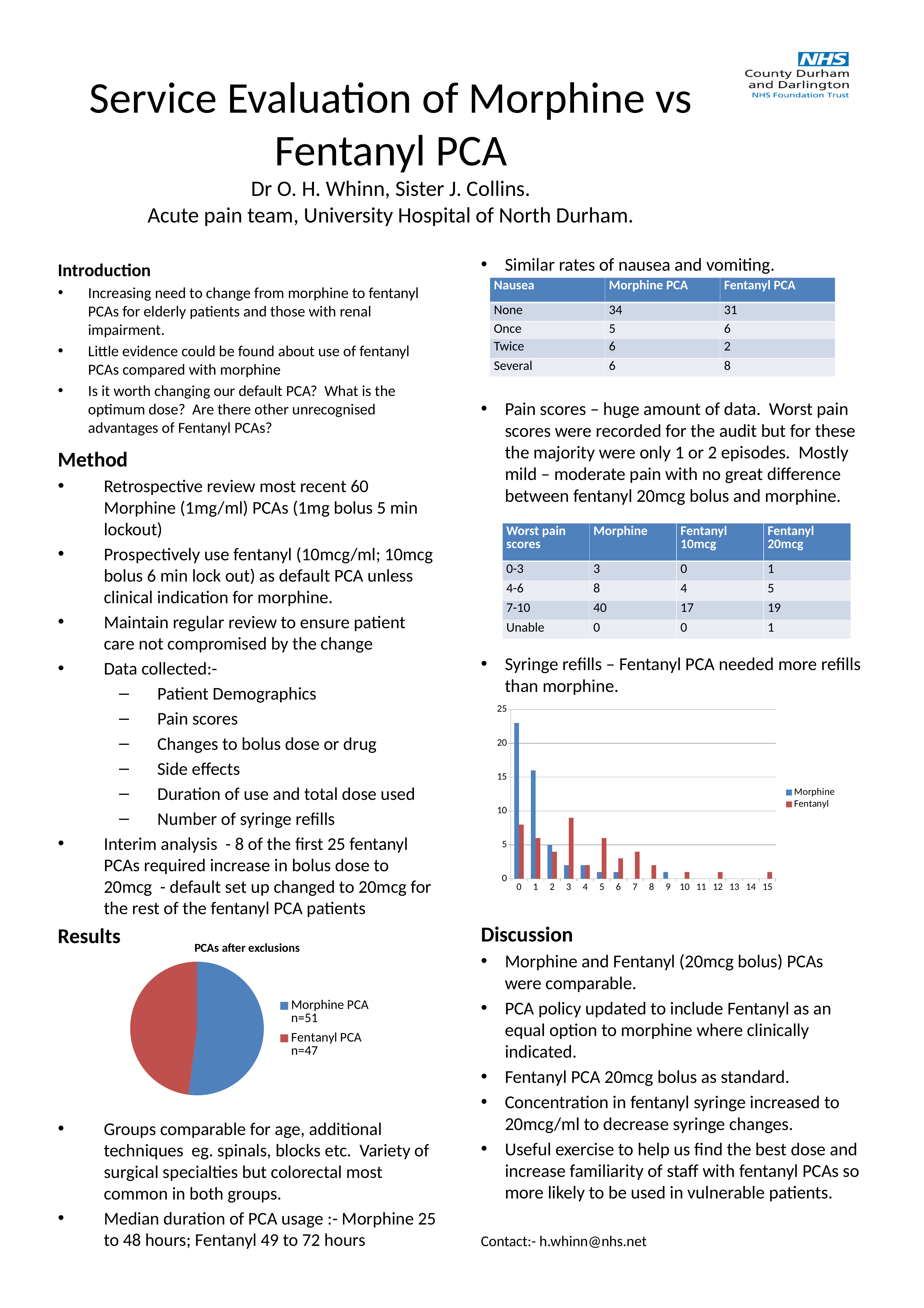
In the syringe refills bar chart on the right, at category 3, which series has the larger value, Morphine or Fentanyl? Fentanyl In the syringe refills bar chart on the right, do the Morphine values generally rise or fall as the x axis increases? fall In the pie chart titled 'PCAs after exclusions', what is the value for Morphine PCA? n=51 In the pie chart titled 'PCAs after exclusions', what is the value for Fentanyl PCA? n=47 In the syringe refills bar chart on the right, is the Morphine value at category 0 greater or less than 20? greater In the syringe refills bar chart on the right, is the Fentanyl value at category 0 greater or less than 10? less In the pie chart titled 'PCAs after exclusions', which group has the larger slice? Morphine PCA In the pie chart titled 'PCAs after exclusions', what is the difference between the Morphine PCA and Fentanyl PCA counts? 4 What kind of chart is the syringe refills chart on the right side of the slide? bar chart In the syringe refills bar chart on the right, how many categories are shown on the x axis? 16 In the syringe refills bar chart on the right, how many series does the legend list? 2 In the pie chart titled 'PCAs after exclusions', how many slices are there? 2